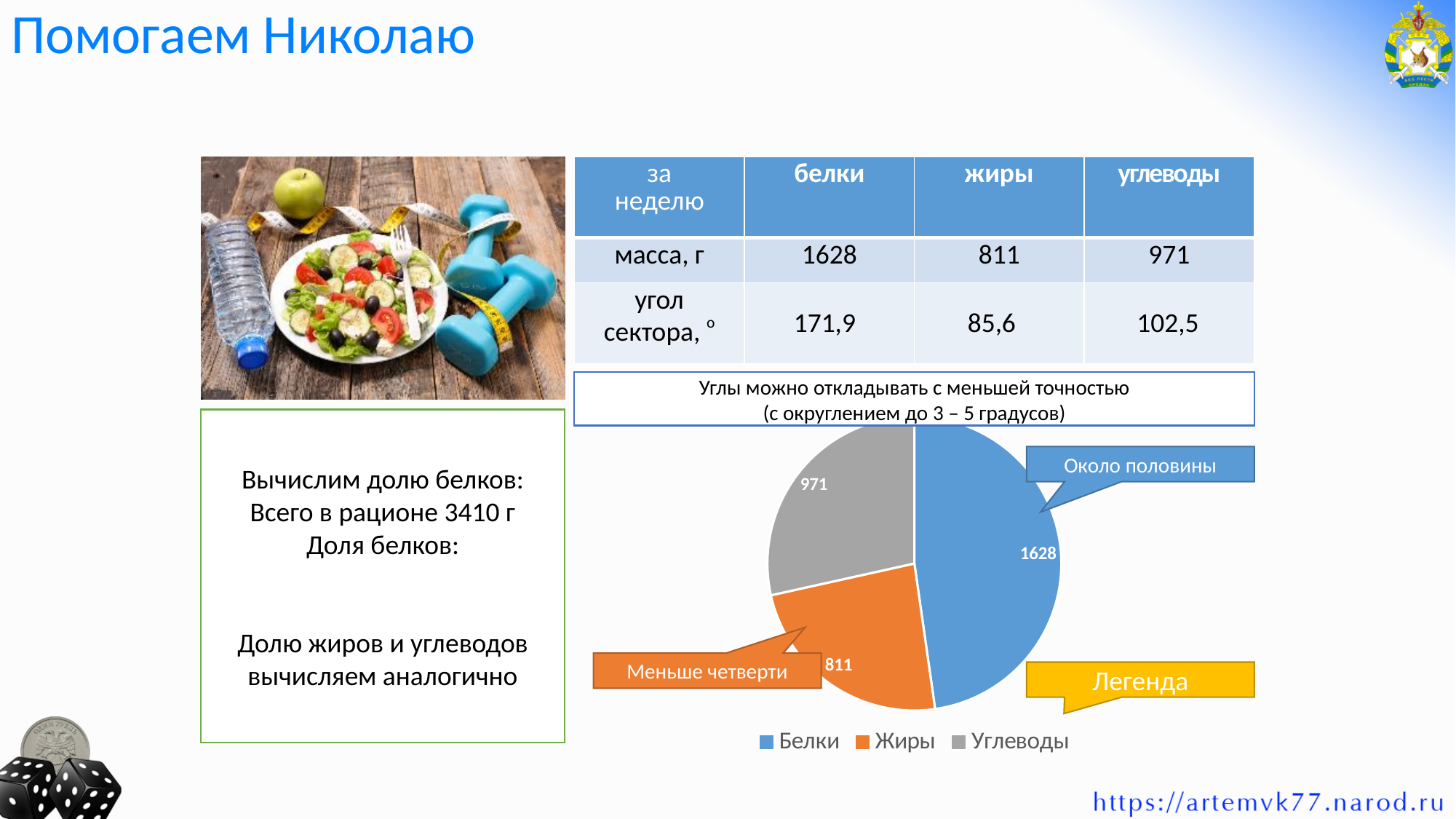
Which slice of the pie chart is the smallest? Жиры What kind of chart is shown on the slide? pie chart What is the difference between the Углеводы and Жиры values in the pie chart? 160 What is the value of the Белки slice in the pie chart? 1628 What is the value of the Жиры slice in the pie chart? 811 What is the value of the Углеводы slice in the pie chart? 971 Which is larger in the pie chart, Углеводы or Жиры? Углеводы What is the difference between the Белки and Жиры values in the pie chart? 817 How many entries does the legend of the pie chart list? 3 What colour is the Жиры slice in the pie chart? orange Which slice of the pie chart is the largest? Белки How many slices does the pie chart have? 3